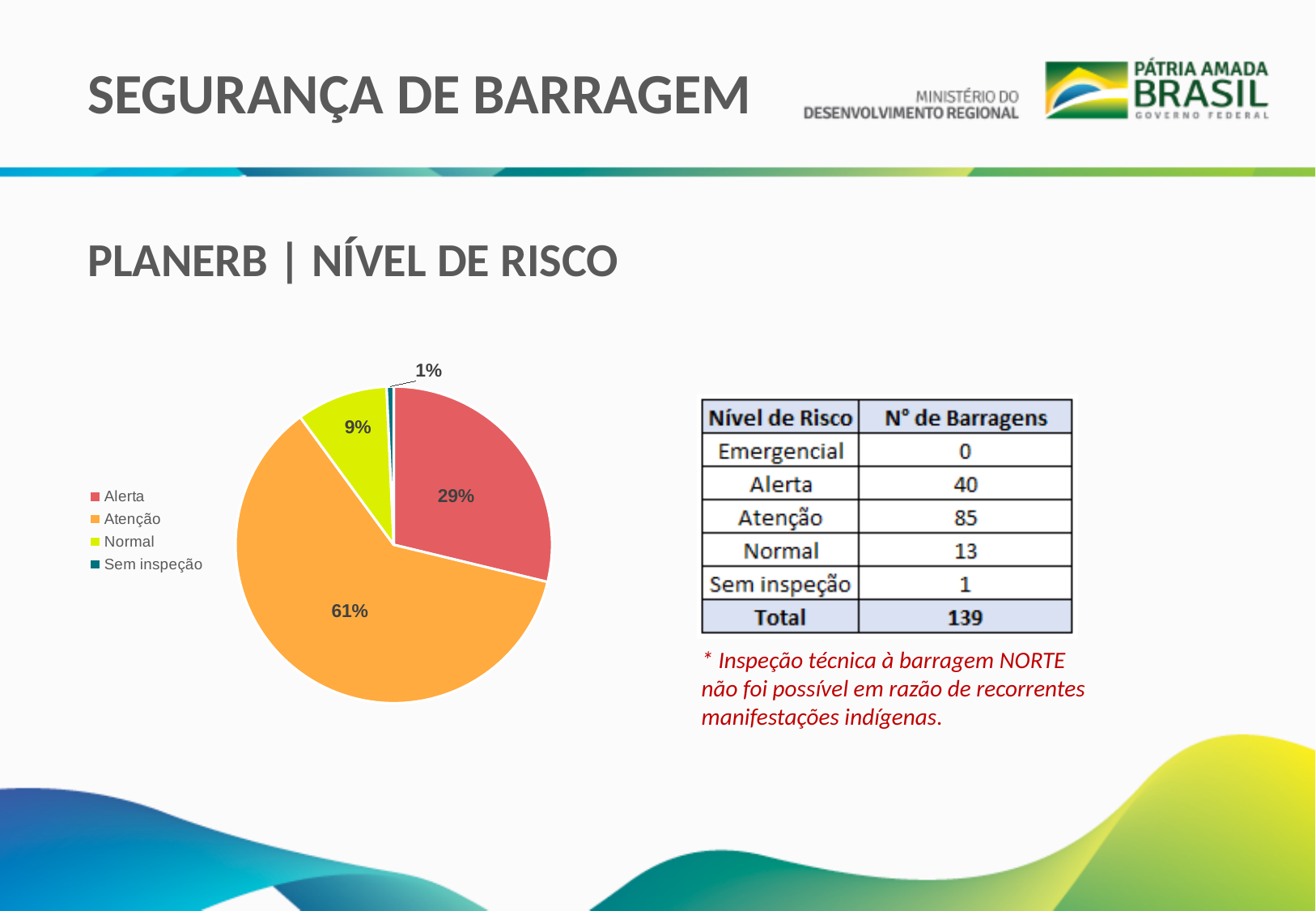
What share of the pie does Atenção represent? 61% What colour is the Atenção slice in the pie chart? Orange Which legend entry is shown in red? Alerta What kind of chart is shown on the slide? Pie chart Which slice is larger, Alerta or Normal? Alerta What share of the pie does Sem inspeção represent? 1% What share of the pie does Alerta represent? 29% Which category has the smallest slice of the pie? Sem inspeção What is the difference in percentage points between the Atenção and Alerta slices? 32% How many categories does the pie chart legend list? 4 Which category has the largest slice of the pie? Atenção